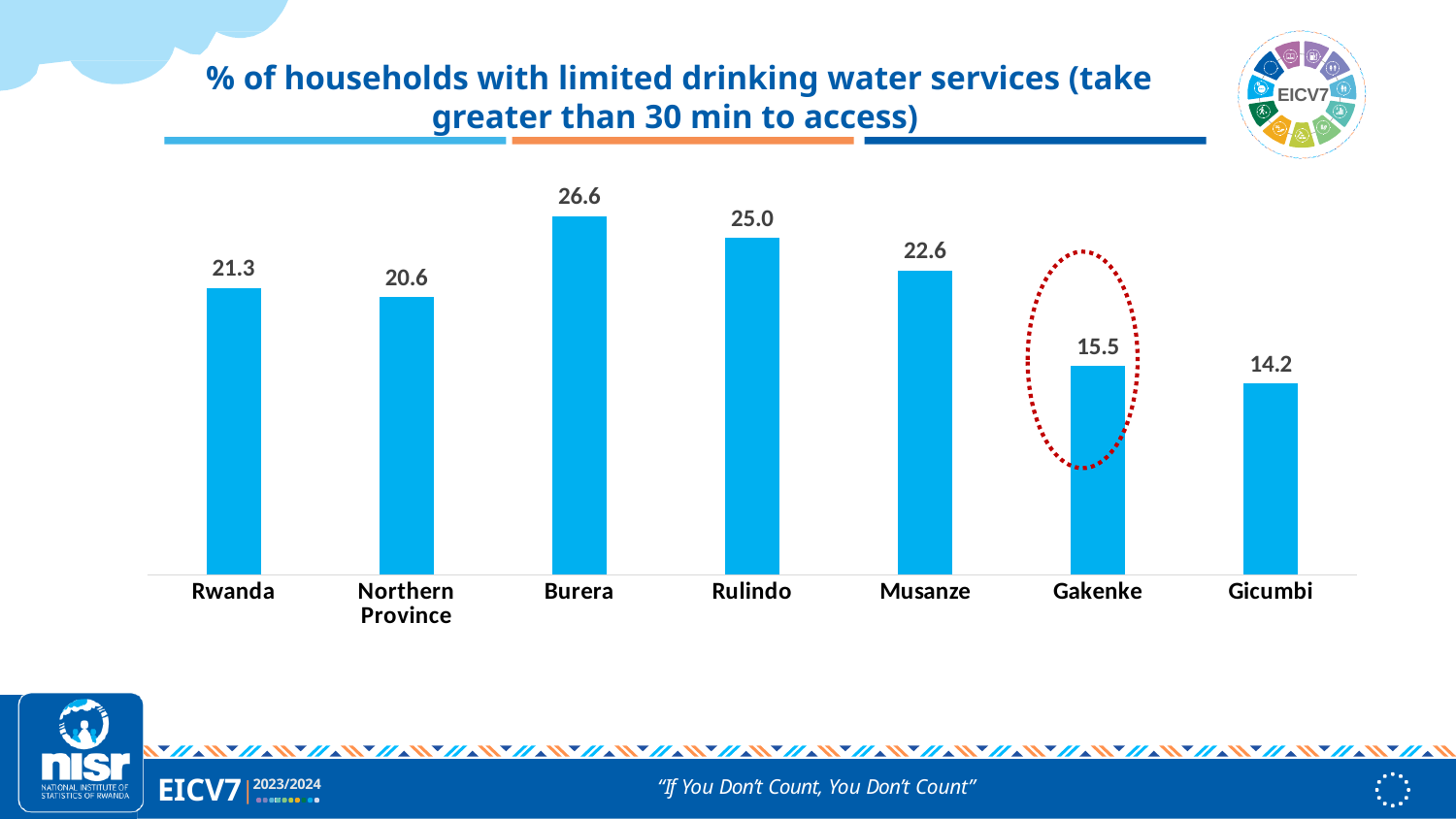
What is the value for Northern Province? 20.6 What is the difference between the values for Rulindo and Musanze? 2.4 How many categories are shown on the x axis? 7 What is the value for Rwanda? 21.3 What is the value for Burera? 26.6 What kind of chart is shown on the slide? Bar chart Which category has the highest value? Burera What is the value for Gakenke? 15.5 Which category has the lowest value? Gicumbi What is the difference between the values for Burera and Gicumbi? 12.4 Which is larger, the value for Musanze or the value for Gakenke? Musanze Which category is highlighted with a red dotted circle? Gakenke